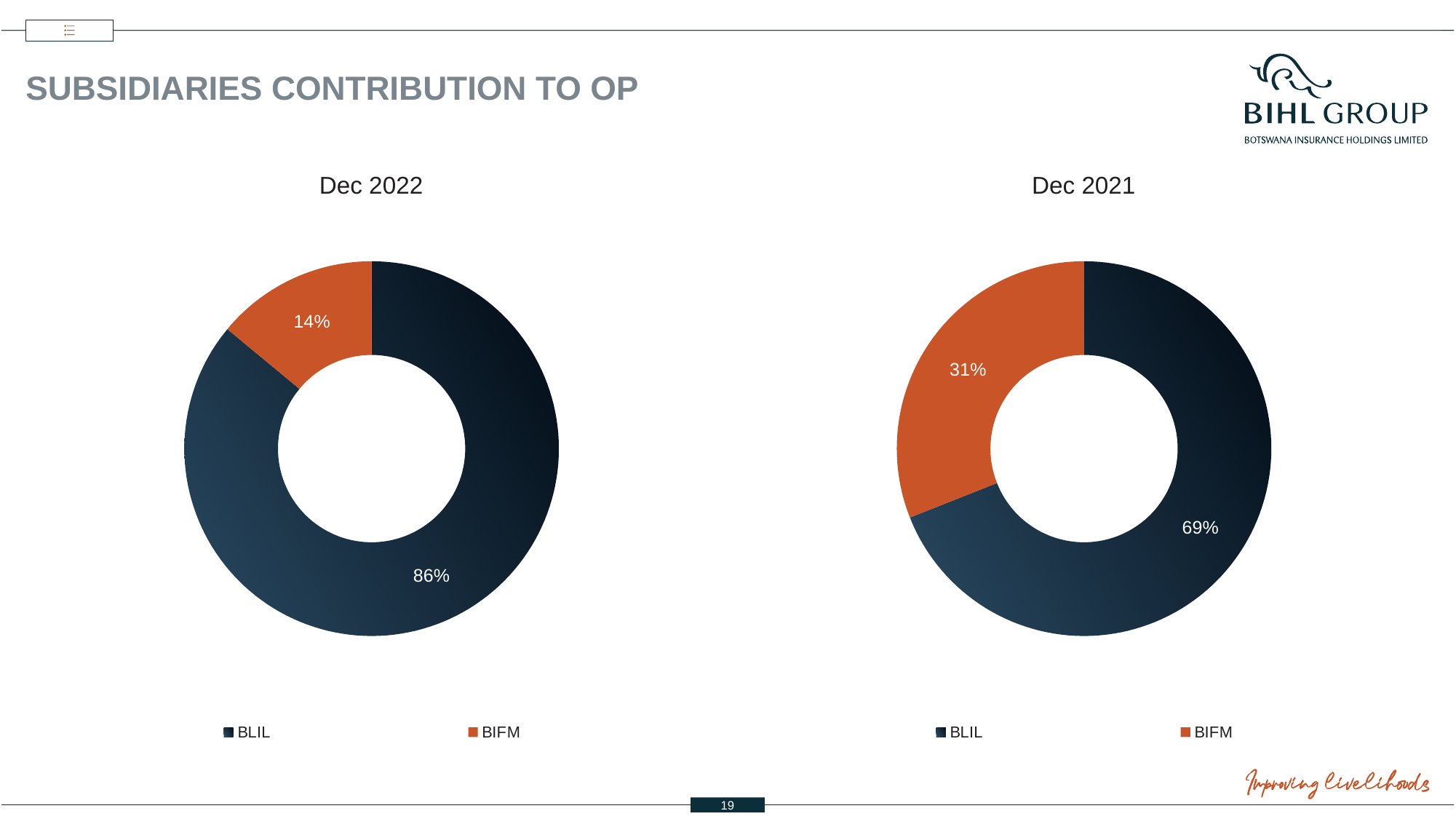
In the Dec 2022 chart, what share does BLIL contribute? 86% In the Dec 2022 chart, what share does BIFM contribute? 14% What kind of chart is the Dec 2022 chart? Doughnut (pie) chart In the Dec 2022 chart, which colour represents BIFM? Orange In the Dec 2021 chart, what is the difference between the BLIL and BIFM shares? 38% How many categories does the Dec 2021 chart show? 2 Is the BIFM share larger in the Dec 2022 chart or the Dec 2021 chart? Dec 2021 In the Dec 2022 chart, which subsidiary has the largest share? BLIL In the Dec 2021 chart, which subsidiary has the smallest share? BIFM In the Dec 2021 chart, what share does BLIL contribute? 69% In the Dec 2022 chart, what is the difference between the BLIL and BIFM shares? 72% In the Dec 2021 chart, what share does BIFM contribute? 31%